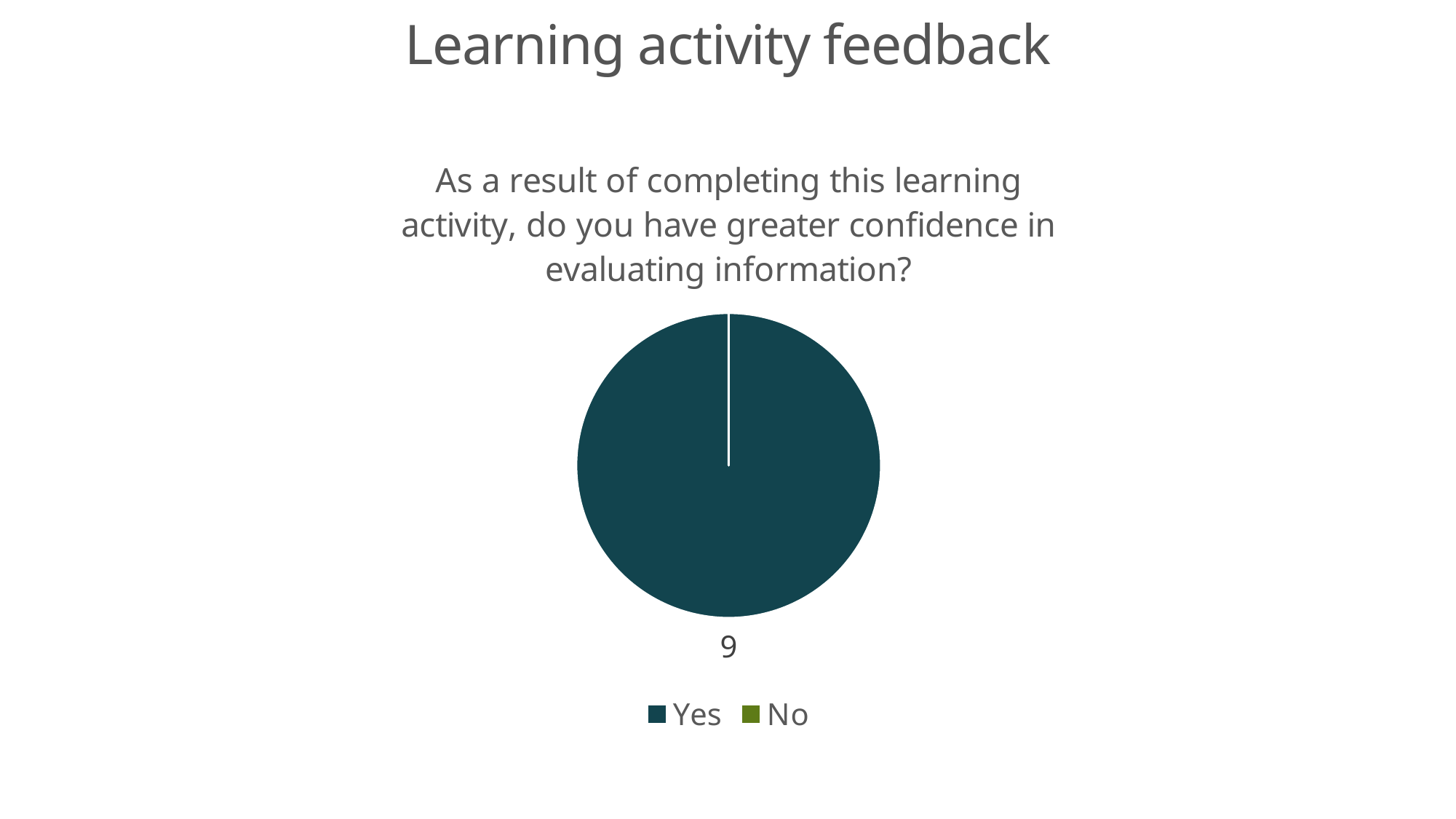
What colour is used for the Yes category in the pie chart legend? dark teal Which category has the smallest slice of the pie chart? No Which is larger in the pie chart, Yes or No? Yes Which category has the largest slice of the pie chart? Yes What is the value shown for the Yes slice of the pie chart? 9 How many categories does the legend of the pie chart list? 2 What is the title of the pie chart? As a result of completing this learning activity, do you have greater confidence in evaluating information? What kind of chart is shown on the slide? pie chart